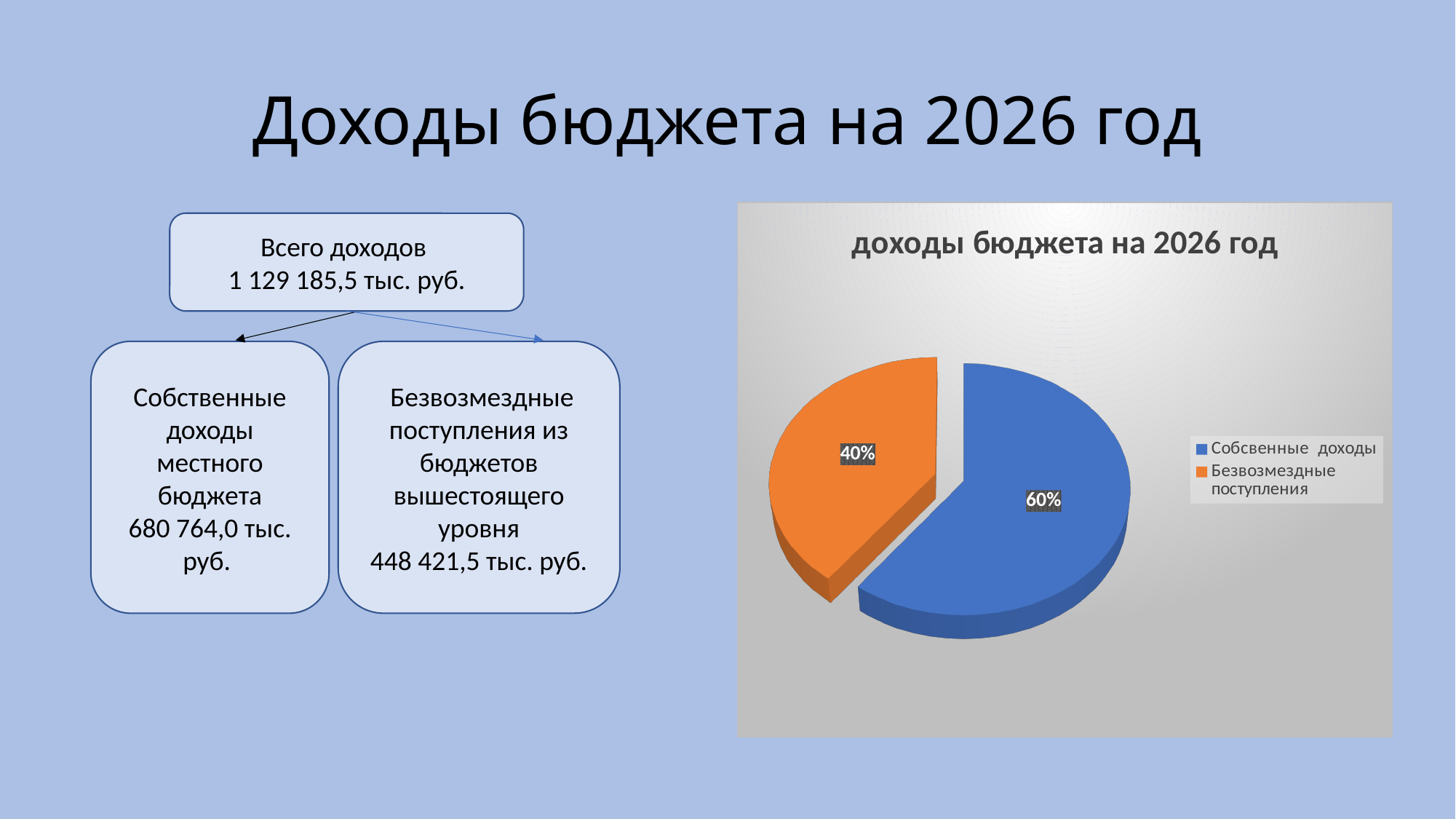
How many entries does the chart legend list? 2 How many slices does the pie chart have? 2 By how many percentage points does the "Собсвенные доходы" share exceed the "Безвозмездные поступления" share? 20 percentage points What share of the pie does "Собсвенные доходы" take? 60% What kind of chart is shown on the slide? pie chart What share of the pie does "Безвозмездные поступления" take? 40% Which slice of the pie is the largest? Собсвенные доходы What colour is the "Безвозмездные поступления" slice? orange Which is larger, the share for "Собсвенные доходы" or the share for "Безвозмездные поступления"? Собсвенные доходы What is the title of the chart? доходы бюджета на 2026 год Which slice of the pie is the smallest? Безвозмездные поступления